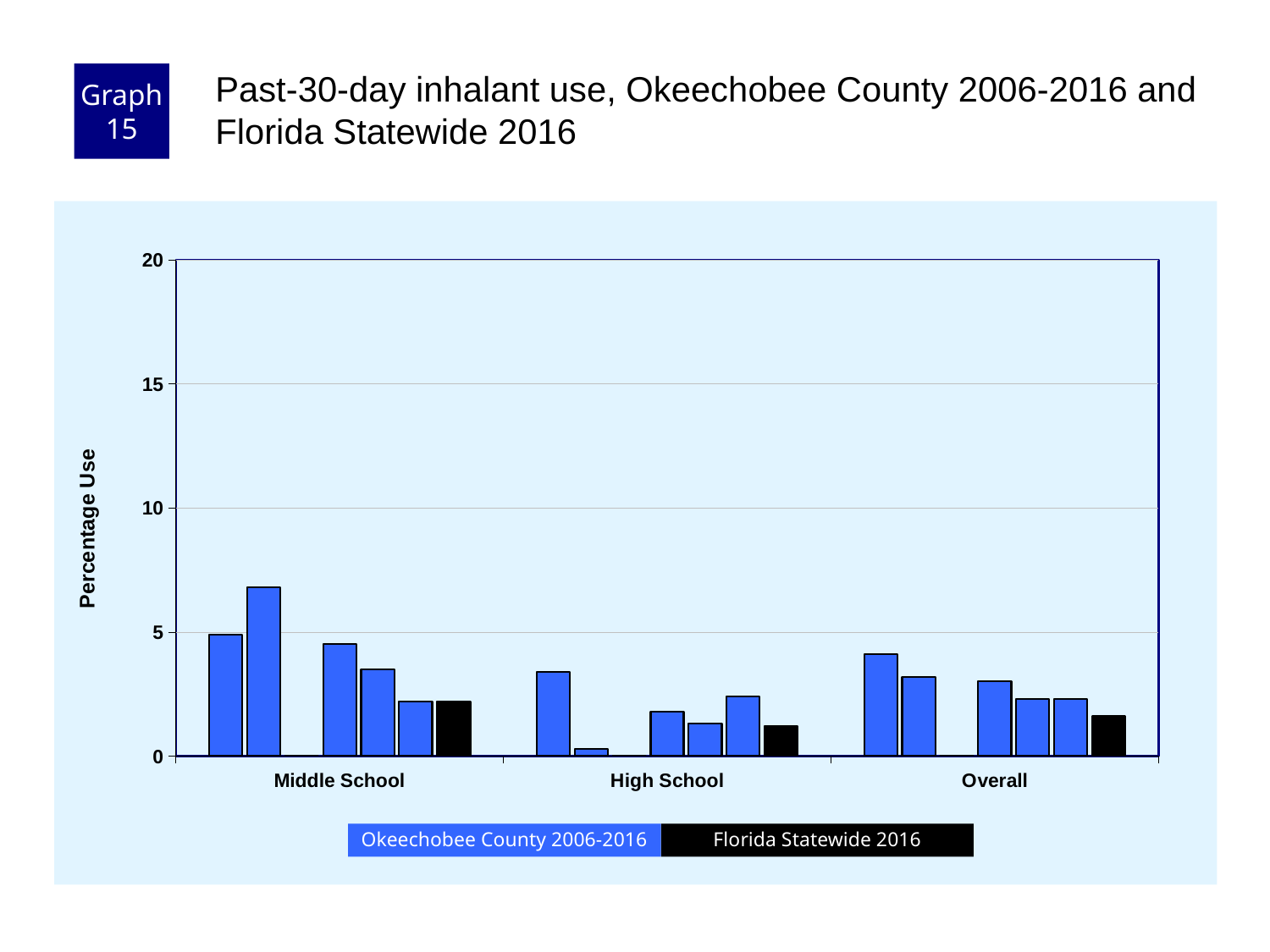
Is the Florida Statewide 2016 value for High School greater or less than 5? less What are the three categories on the x axis? Middle School, High School, Overall What is the label of the y axis? Percentage Use How many series does the legend list? 2 Is any bar on the chart greater than 10? No Is the Florida Statewide 2016 value for Middle School greater or less than 5? less Which category has the highest Florida Statewide 2016 value? Middle School Which category has the lowest Florida Statewide 2016 value? High School What kind of chart is shown on the slide? bar chart Which is larger, the Florida Statewide 2016 value for Middle School or for High School? Middle School How many categories are shown on the x axis? 3